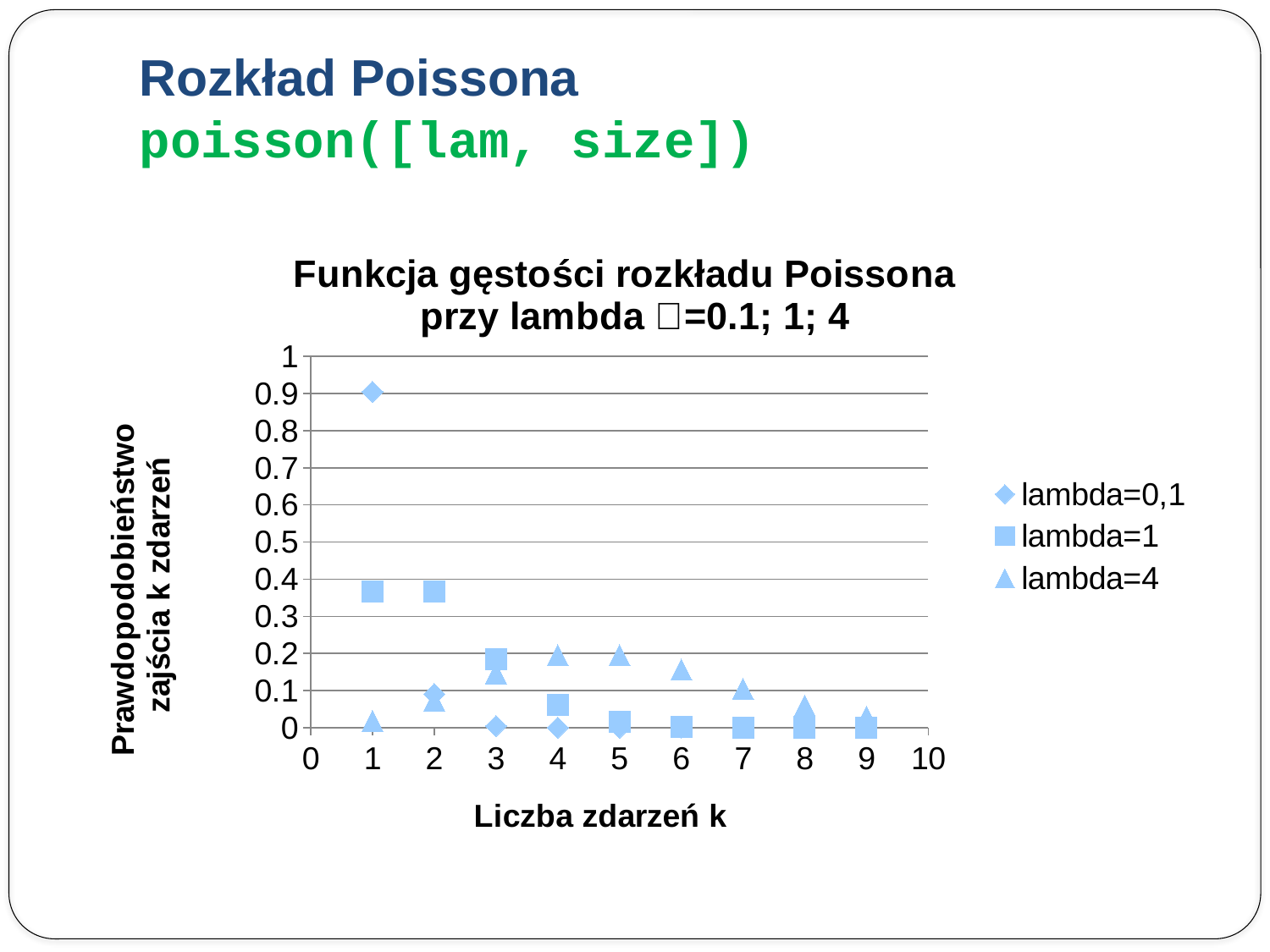
At k=1, which series has the larger value: lambda=0,1 or lambda=1? lambda=0,1 What is the label of the x axis? Liczba zdarzeń k What kind of chart is shown on the slide? scatter chart Is the value for lambda=4 at k=1 greater or less than 0.1? less Is the value for lambda=4 at k=4 greater or less than 0.3? less For the lambda=0,1 series, at which value of k is the probability highest? 1 How many series does the legend list? 3 Do the values of the lambda=0,1 series rise or fall as k increases? fall Is the value for lambda=0,1 at k=1 greater or less than 0.8? greater At k=5, which series has the larger value: lambda=4 or lambda=1? lambda=4 Which series has the highest plotted value on the chart? lambda=0,1